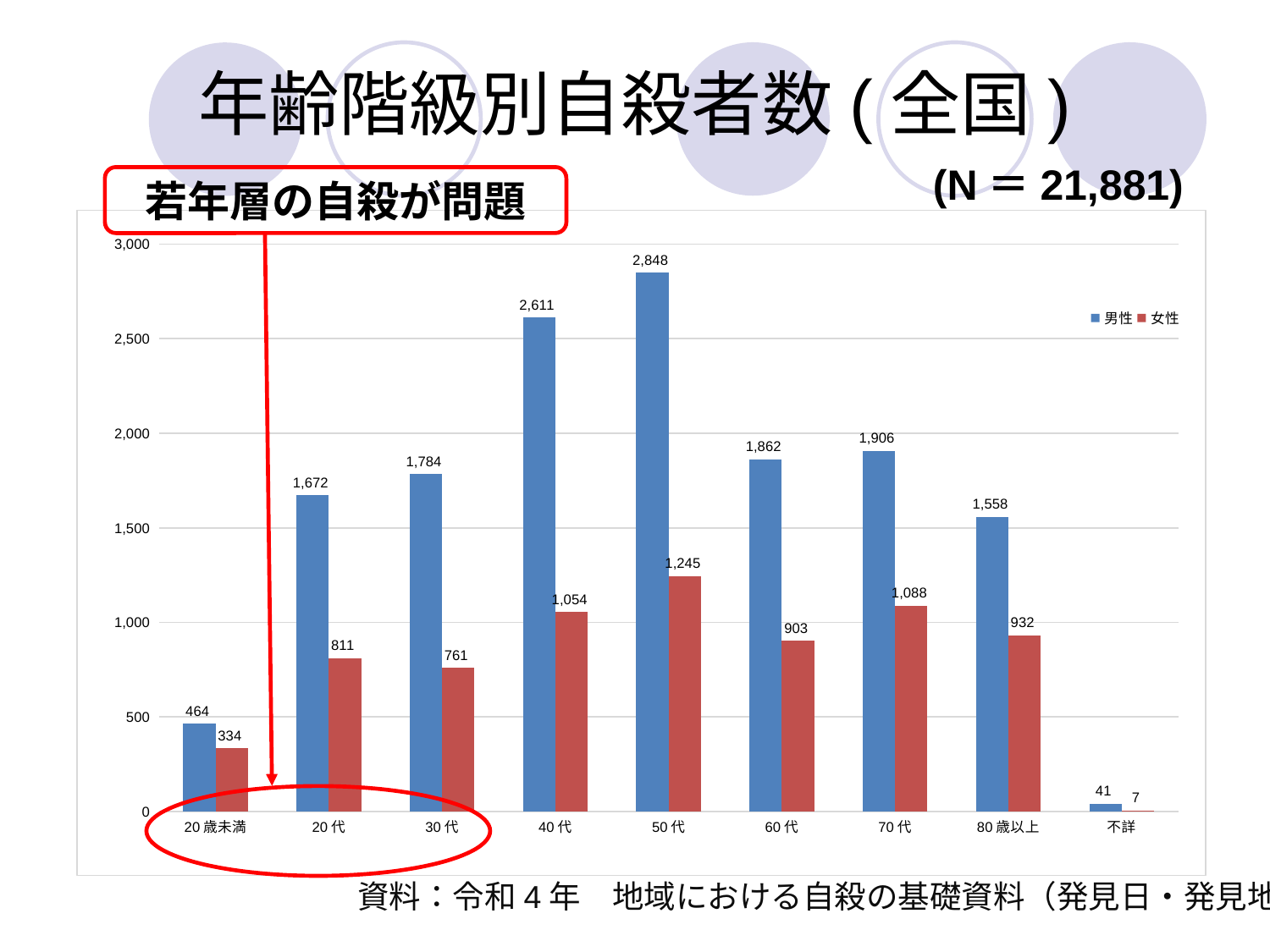
Which is larger, the 女性 value for 70代 or the 女性 value for 60代? 70代 What is the value for 男性 in the 20歳未満 category? 464 What is the sample size (N) stated on the slide? 21,881 What kind of chart is shown on the slide? bar chart What is the value for 男性 in the 50代 category? 2,848 How many age categories are shown on the x axis? 9 Is the 男性 value for 80歳以上 greater or less than 1,500? greater What is the value for 女性 in the 40代 category? 1,054 How many series does the legend list? 2 Which age category has the highest 男性 value? 50代 What is the difference between the 男性 and 女性 values in the 30代 category? 1,023 Which age category has the lowest 女性 value? 不詳